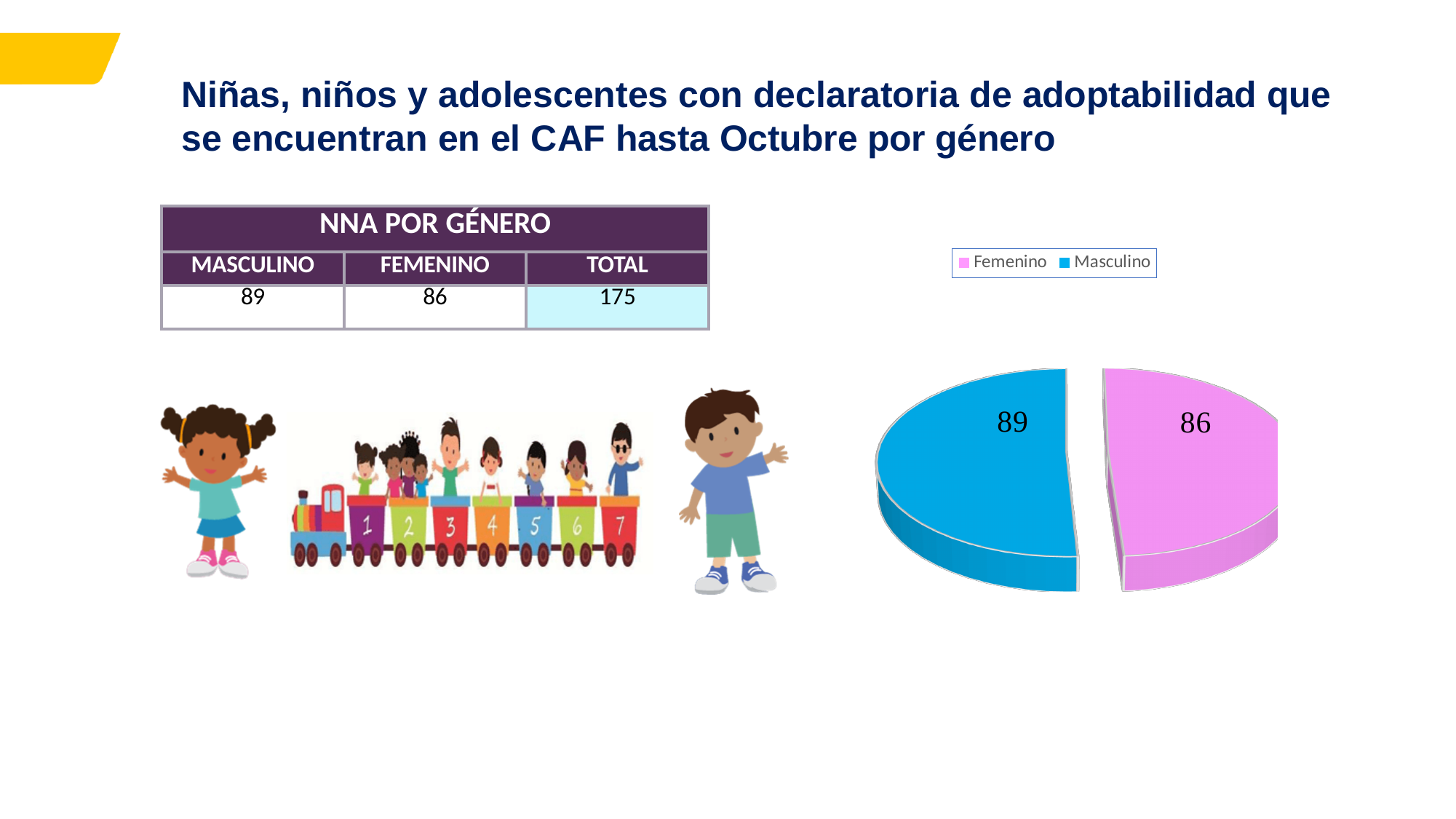
Is the Masculino value larger or smaller than the Femenino value in the pie chart? larger What type of chart is shown on the slide? pie chart What is the value of the Femenino slice in the pie chart? 86 Which slice of the pie chart has the larger value? Masculino What is the total of the two slices in the pie chart? 175 What colour is the Femenino slice in the pie chart? pink What is the value of the Masculino slice in the pie chart? 89 What is the difference between the Masculino and Femenino values in the pie chart? 3 Which slice of the pie chart has the smaller value? Femenino What colour is the Masculino slice in the pie chart? blue How many entries does the pie chart legend list? 2 How many slices does the pie chart have? 2